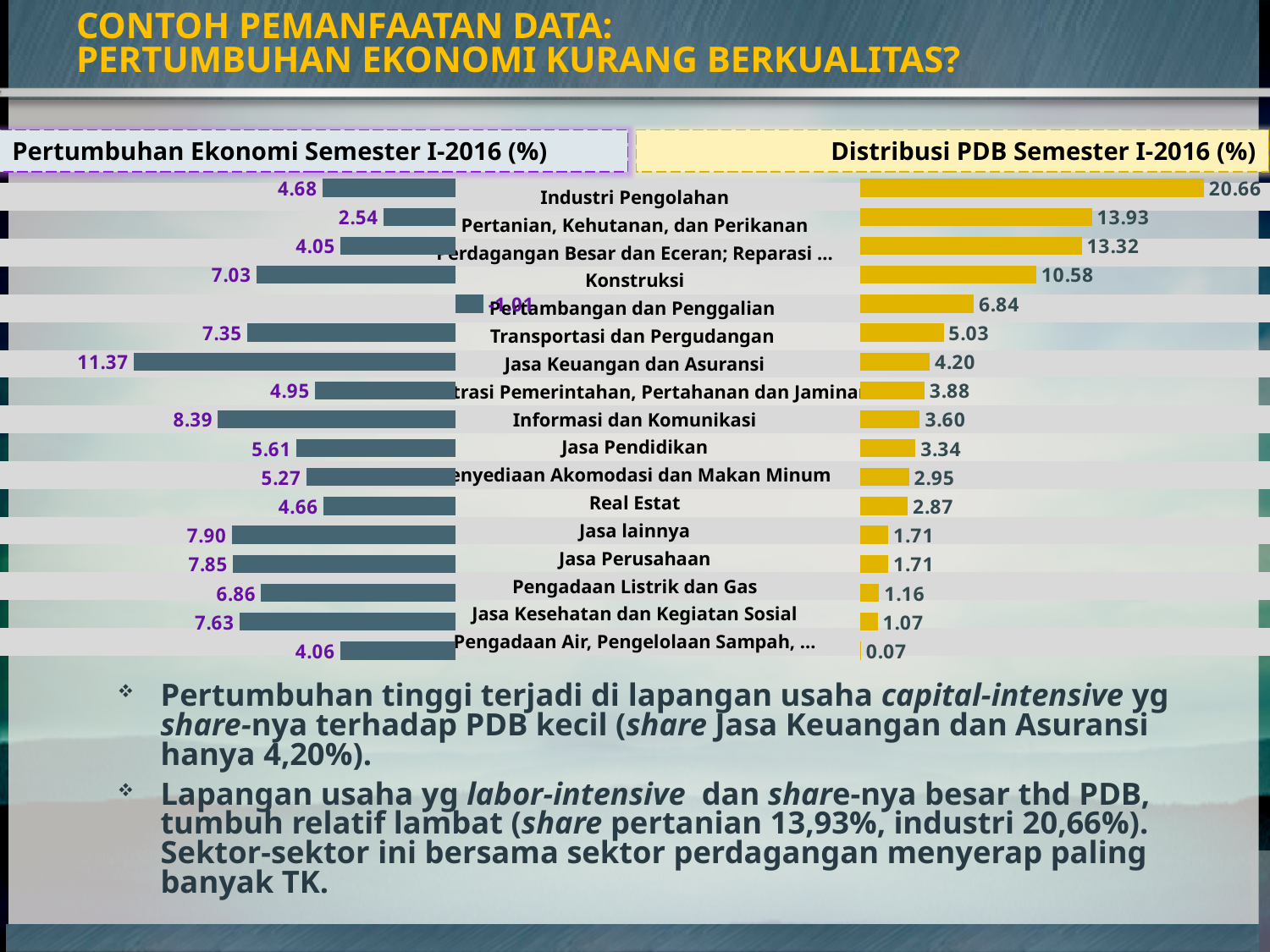
On the Distribusi PDB Semester I-2016 (%) chart, which category has the highest value? Industri Pengolahan On the Pertumbuhan Ekonomi Semester I-2016 (%) chart, what is the value for Jasa Keuangan dan Asuransi? 11.37 On the Pertumbuhan Ekonomi Semester I-2016 (%) chart, what is the value for Konstruksi? 7.03 On the Distribusi PDB Semester I-2016 (%) chart, what is the value for Industri Pengolahan? 20.66 How many categories are shown on the Distribusi PDB Semester I-2016 (%) chart? 17 On the Distribusi PDB Semester I-2016 (%) chart, what is the difference between Industri Pengolahan and Pertanian, Kehutanan, dan Perikanan? 6.73 On the Pertumbuhan Ekonomi Semester I-2016 (%) chart, which category has the highest value? Jasa Keuangan dan Asuransi On the Pertumbuhan Ekonomi Semester I-2016 (%) chart, what is the difference between Jasa lainnya and Jasa Perusahaan? 0.05 On the Distribusi PDB Semester I-2016 (%) chart, which category has the lowest value? Pengadaan Air, Pengelolaan Sampah, ... On the Distribusi PDB Semester I-2016 (%) chart, what is the value for Pertanian, Kehutanan, dan Perikanan? 13.93 What type of chart is the Distribusi PDB Semester I-2016 (%) chart? Bar chart On the Pertumbuhan Ekonomi Semester I-2016 (%) chart, which is larger: Informasi dan Komunikasi or Jasa Pendidikan? Informasi dan Komunikasi